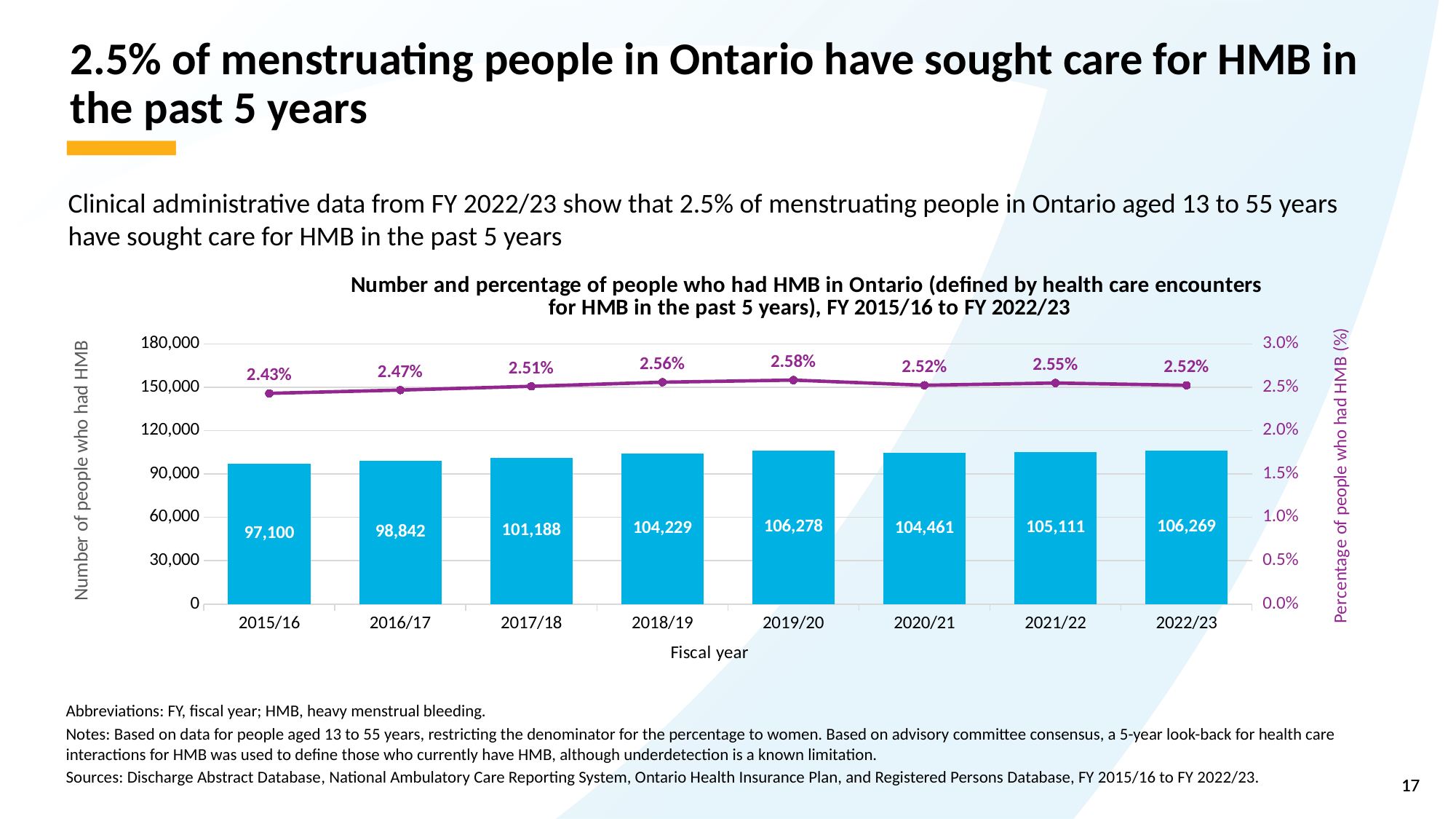
What percentage of people had HMB in FY 2015/16? 2.43% In which fiscal year was the percentage of people who had HMB the highest? 2019/20 In which fiscal year was the number of people who had HMB the lowest? 2015/16 Which fiscal year had more people with HMB, 2017/18 or 2021/22? 2021/22 How many fiscal years are shown on the x axis of the chart? 8 What is the difference in the percentage of people who had HMB between FY 2019/20 and FY 2015/16? 0.15% What percentage of people had HMB in FY 2019/20? 2.58% How many people had HMB in Ontario in FY 2015/16? 97,100 What is the number of people who had HMB in FY 2022/23? 106,269 What kind of chart is used to show the number of people who had HMB? Bar chart (with a line for percentage) Did the percentage of people who had HMB rise or fall from FY 2015/16 to FY 2019/20? Rise By how much did the number of people who had HMB increase from FY 2015/16 to FY 2022/23? 9,169